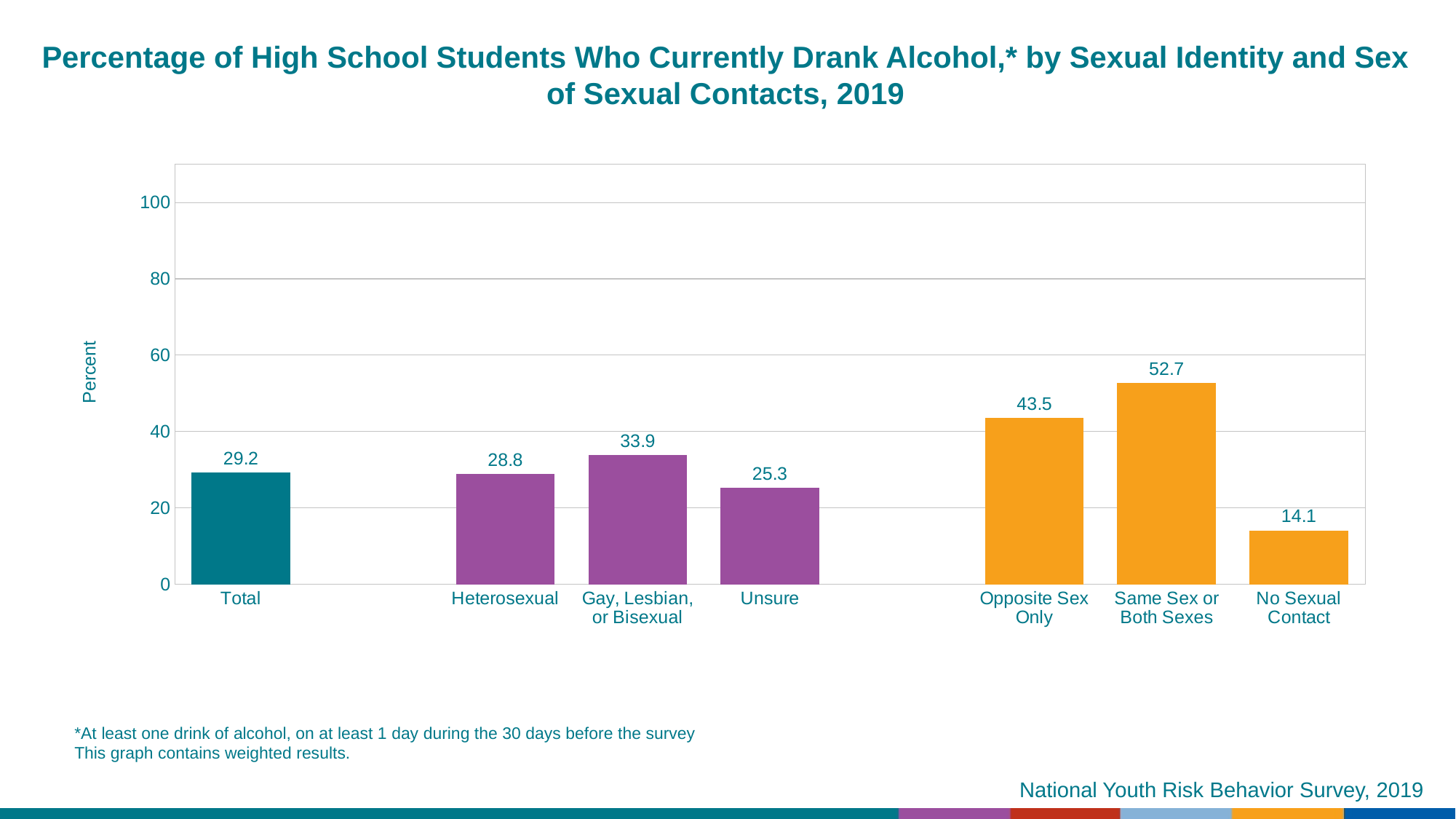
Which category has the lowest value? No Sexual Contact What is the value for No Sexual Contact? 14.1 Which is larger, the value for Gay, Lesbian, or Bisexual or the value for Unsure? Gay, Lesbian, or Bisexual What is the value for Gay, Lesbian, or Bisexual? 33.9 What is the label on the vertical axis? Percent What kind of chart is shown on the slide? Bar chart What is the value for Total? 29.2 How many categories are shown in the chart? 7 What is the difference between the values for Same Sex or Both Sexes and Opposite Sex Only? 9.2 Is the value for Opposite Sex Only greater or less than 40? greater What is the value for Heterosexual? 28.8 Which category has the highest value? Same Sex or Both Sexes